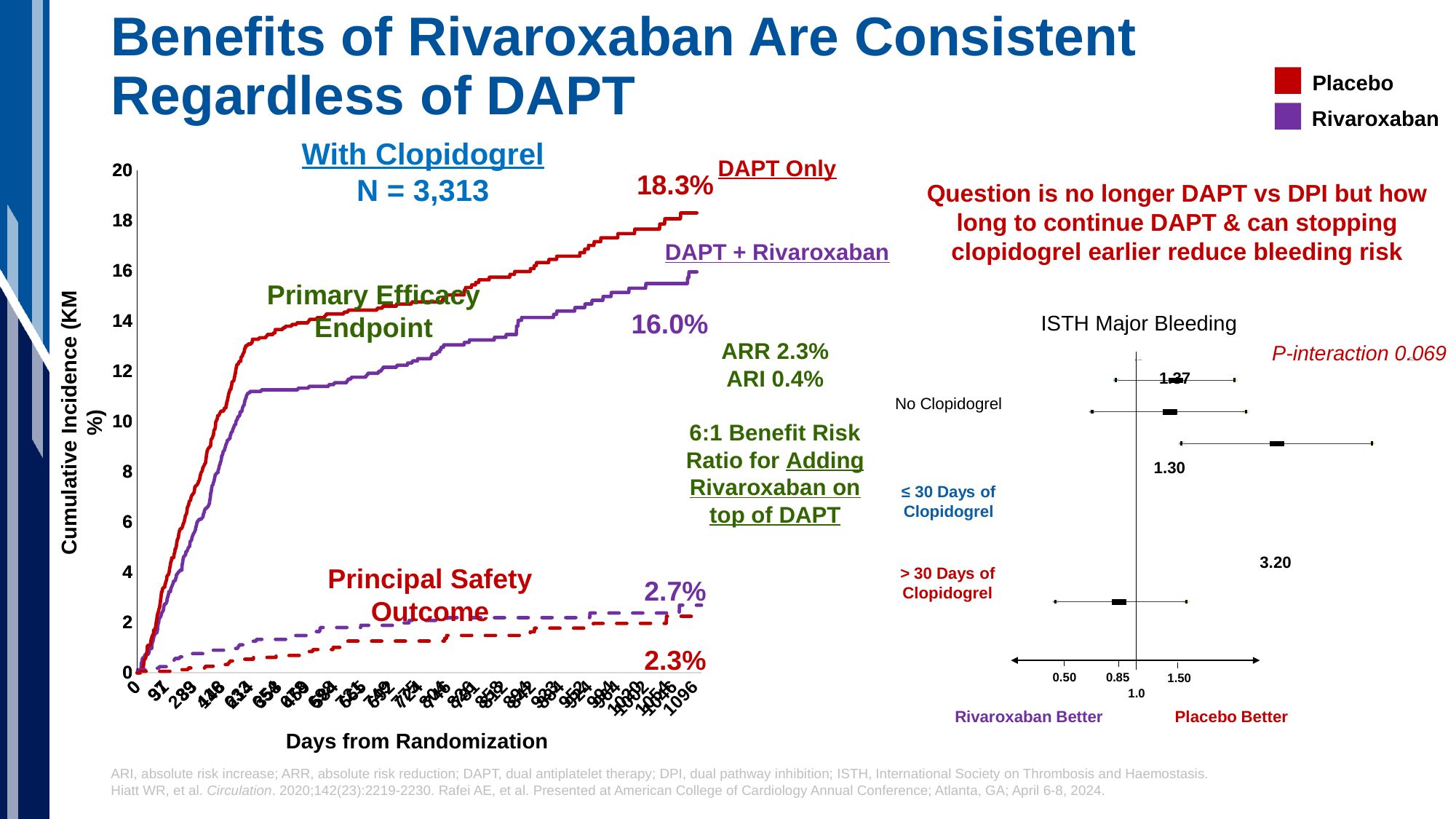
What is the x-axis title of the Kaplan-Meier chart on the left? Days from Randomization In the Kaplan-Meier chart on the left, what is the difference between the rivaroxaban and placebo principal safety outcome values? 0.4% In the ISTH Major Bleeding forest plot on the right, what is the P-interaction value shown? 0.069 In the Kaplan-Meier chart on the left, is the DAPT Only primary efficacy endpoint value at the end of follow-up greater or less than 18? greater In the Kaplan-Meier chart on the left, what is the cumulative incidence of the primary efficacy endpoint for the DAPT + Rivaroxaban group? 16.0% In the Kaplan-Meier chart on the left, which group has the higher cumulative incidence of the primary efficacy endpoint, DAPT Only or DAPT + Rivaroxaban? DAPT Only What kind of chart is the chart on the left of the slide? Line chart In the Kaplan-Meier chart on the left, what is the cumulative incidence of the principal safety outcome for the rivaroxaban (purple dashed) line? 2.7% In the Kaplan-Meier chart on the left, what is the cumulative incidence of the principal safety outcome for the placebo (red dashed) line? 2.3% In the Kaplan-Meier chart on the left, what is the cumulative incidence of the primary efficacy endpoint for the DAPT Only group at the end of follow-up? 18.3% How many series does the legend in the top right of the slide list? 2 In the Kaplan-Meier chart on the left, what is the difference between the DAPT Only and DAPT + Rivaroxaban primary efficacy endpoint values? 2.3%